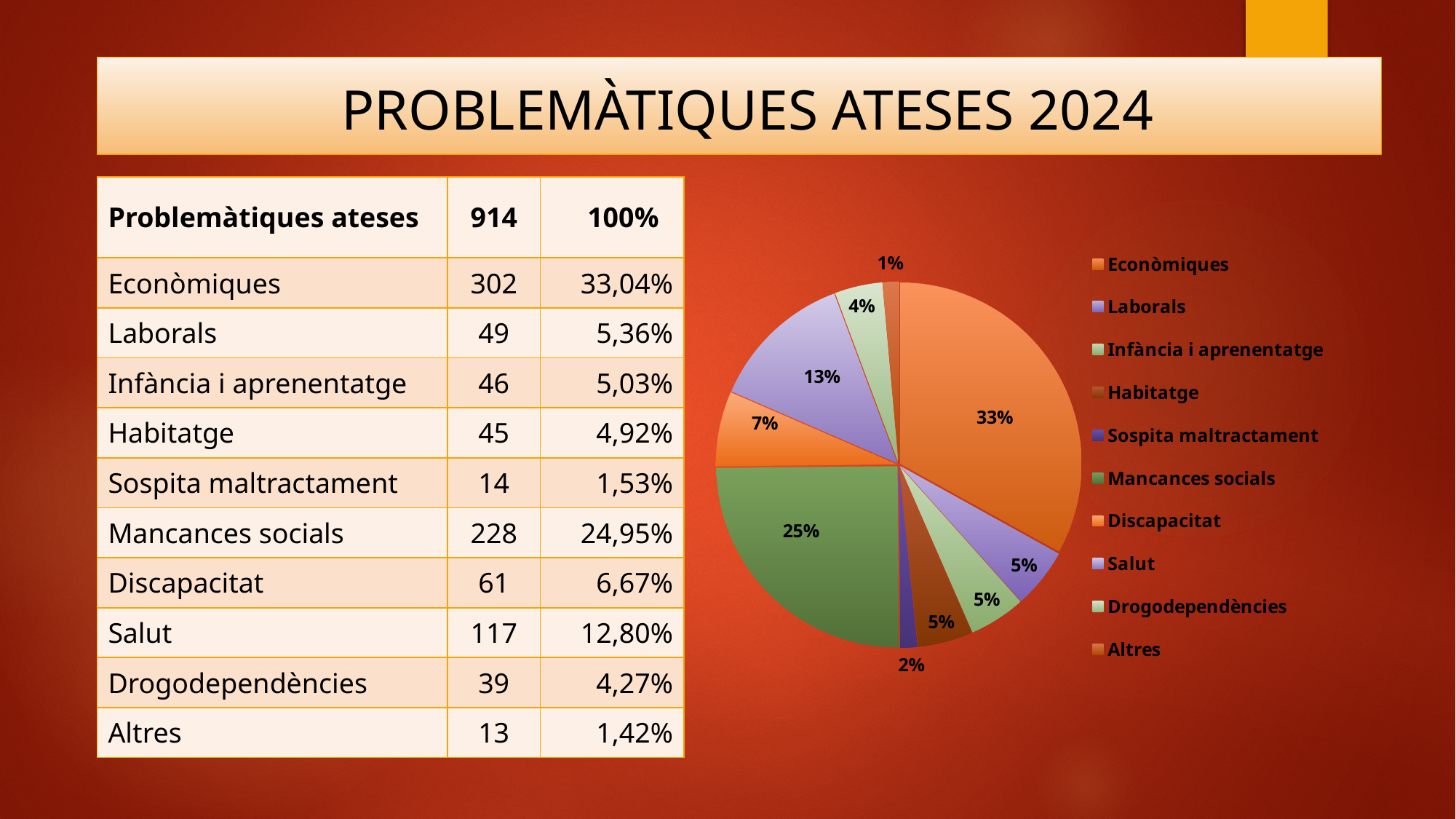
In the pie chart, what share is labelled for Drogodependències? 4% How many categories does the pie chart legend list? 10 Which slice is larger in the pie chart, Salut or Discapacitat? Salut What kind of chart is shown on the slide? pie chart In the pie chart, what share is labelled for Econòmiques? 33% Which category has the largest slice in the pie chart? Econòmiques In the pie chart, what share is labelled for Salut? 13% Which category has the smallest slice in the pie chart? Altres What is the difference in percentage points between the Econòmiques slice and the Mancances socials slice in the pie chart? 8%